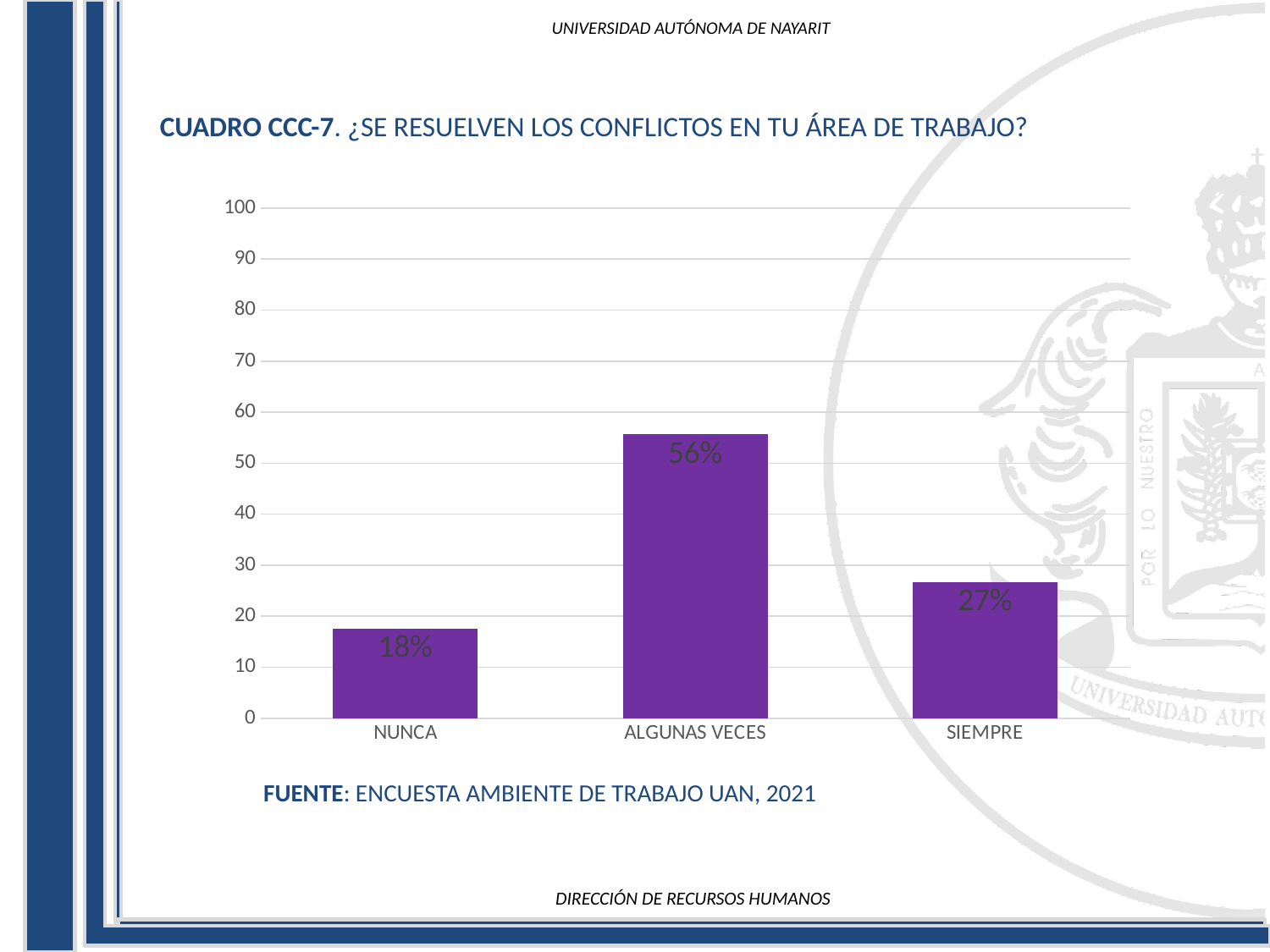
Which category has the lowest value? NUNCA What is the value for NUNCA? 18% What is the difference between the values for ALGUNAS VECES and SIEMPRE? 29% Is the value for ALGUNAS VECES greater or less than 50? greater What is the source cited below the chart? ENCUESTA AMBIENTE DE TRABAJO UAN, 2021 What is the difference between the values for SIEMPRE and NUNCA? 9% What is the value for ALGUNAS VECES? 56% How many categories are shown on the x axis? 3 What is the value for SIEMPRE? 27% Which is larger, the value for SIEMPRE or the value for NUNCA? SIEMPRE What kind of chart is shown on the slide? bar chart Which category has the highest value? ALGUNAS VECES